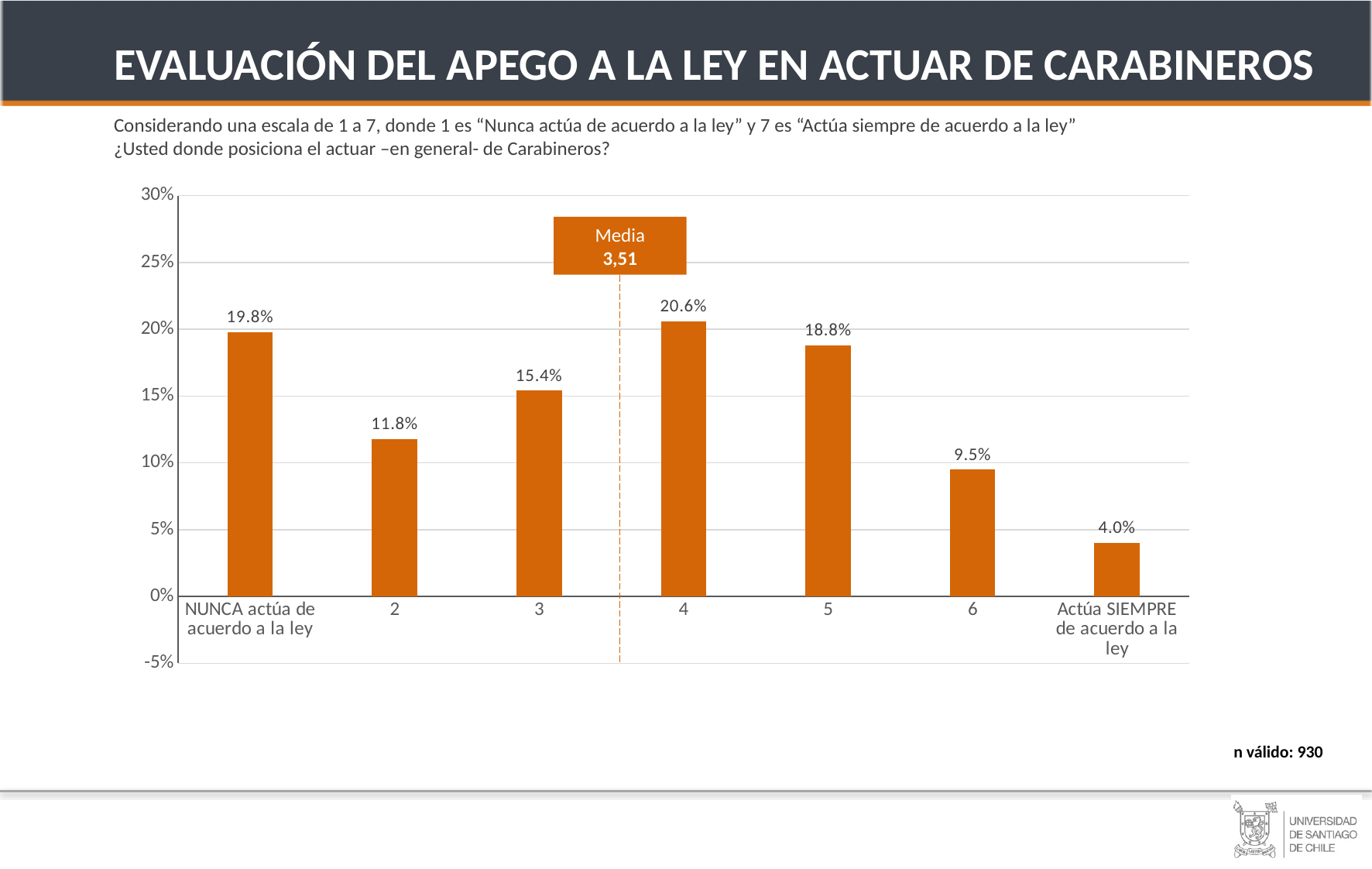
What is the value for category 6? 9.5% What is the value for category 4? 20.6% What is the difference between the values for category 4 and category 5? 1.8% Which category has the lowest value? Actúa SIEMPRE de acuerdo a la ley What mean (Media) value is shown on the chart? 3,51 What is the difference between the values for category 3 and category 2? 3.6% How many categories are shown on the x axis? 7 Which is larger, the value for category 2 or the value for category 3? 3 What kind of chart is shown on the slide? bar chart Which category has the highest value? 4 What is the value for "Actúa SIEMPRE de acuerdo a la ley"? 4.0% What is the value for "NUNCA actúa de acuerdo a la ley"? 19.8%